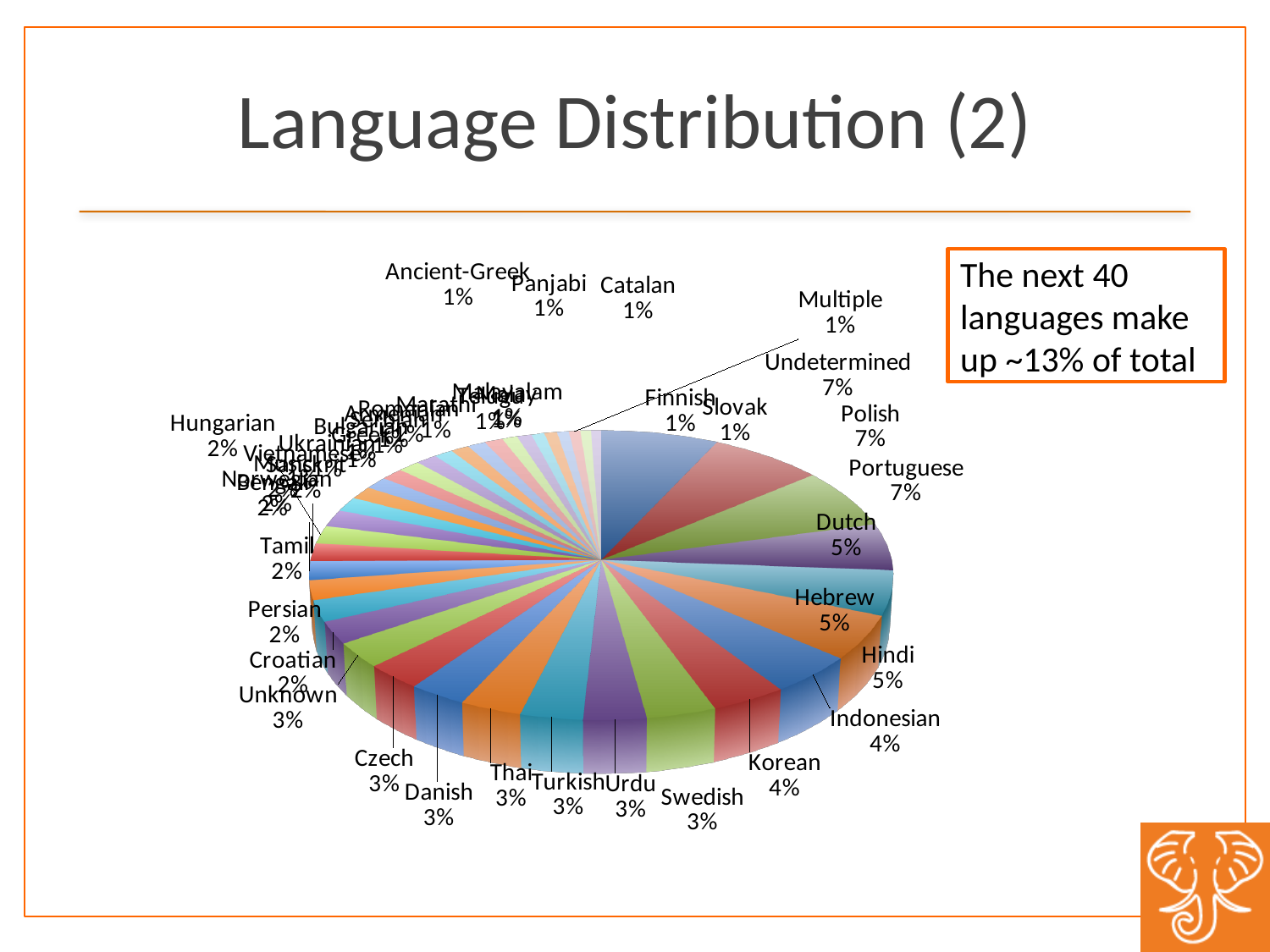
What percentage is shown for Indonesian? 4% Which has the larger share, Undetermined or Hindi? Undetermined What percentage is shown for Hungarian? 2% What is the title of the slide containing the pie chart? Language Distribution (2) What share of the pie does Polish account for? 7% What percentage is shown for Dutch? 5% What is the difference between the shares of Portuguese and Hebrew? 2% Which has the larger share, Korean or Persian? Korean According to the text box next to the chart, roughly what share of the total do the next 40 languages make up? ~13% What percentage is shown for Czech? 3% What percentage is shown for Catalan? 1% What type of chart is shown on the slide? pie chart